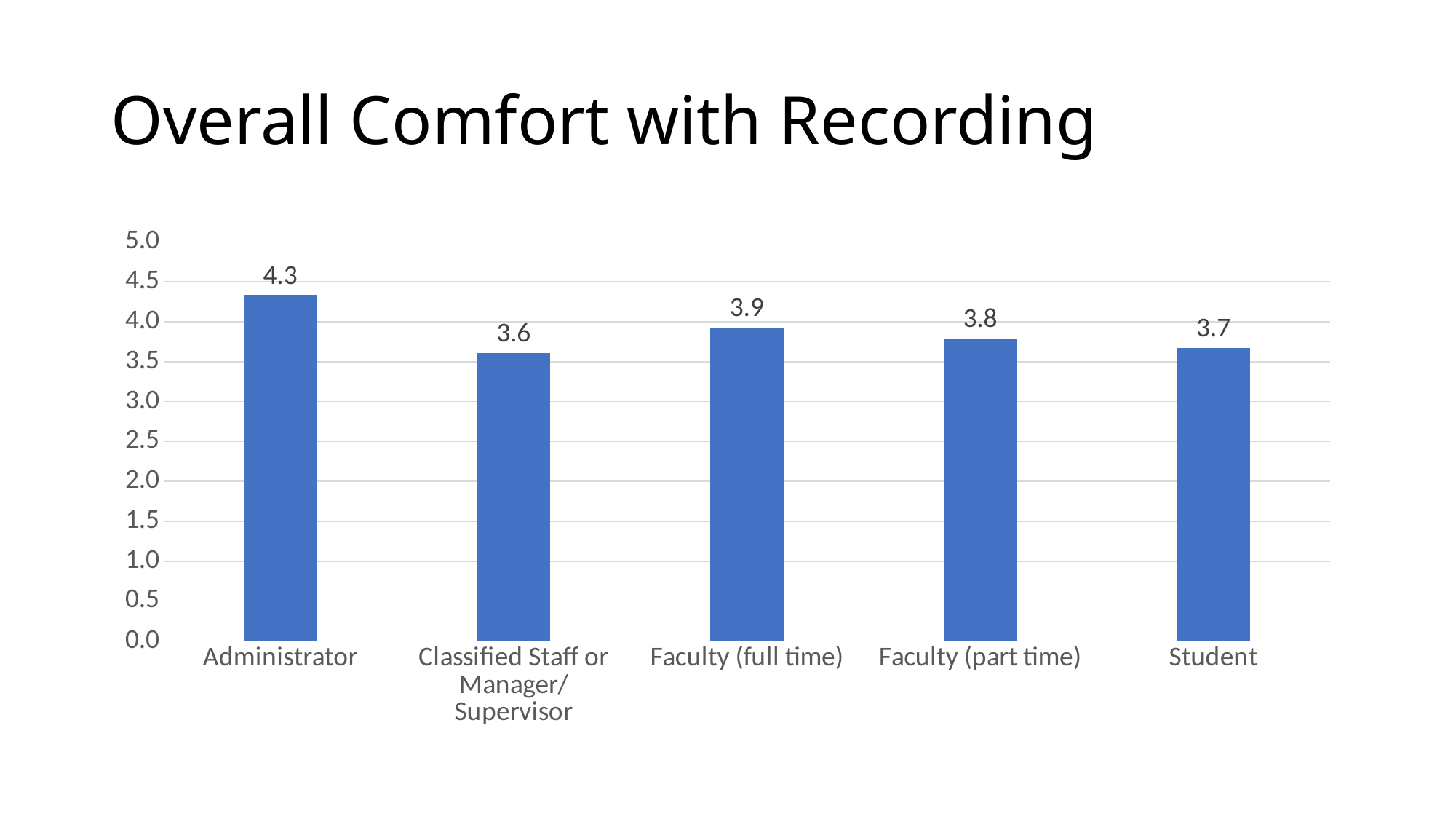
Which category has the highest value? Administrator Is the value for Administrator greater or less than 4.0? greater What is the value for Classified Staff or Manager/Supervisor? 3.6 What is the value for Student? 3.7 What is the value for Faculty (full time)? 3.9 Which is larger, the value for Faculty (full time) or Faculty (part time)? Faculty (full time) What is the value for Administrator? 4.3 Which category has the lowest value? Classified Staff or Manager/Supervisor What is the difference between the values for Administrator and Student? 0.6 What kind of chart is shown on the slide? Bar chart What is the title of the slide? Overall Comfort with Recording How many categories are shown on the chart? 5